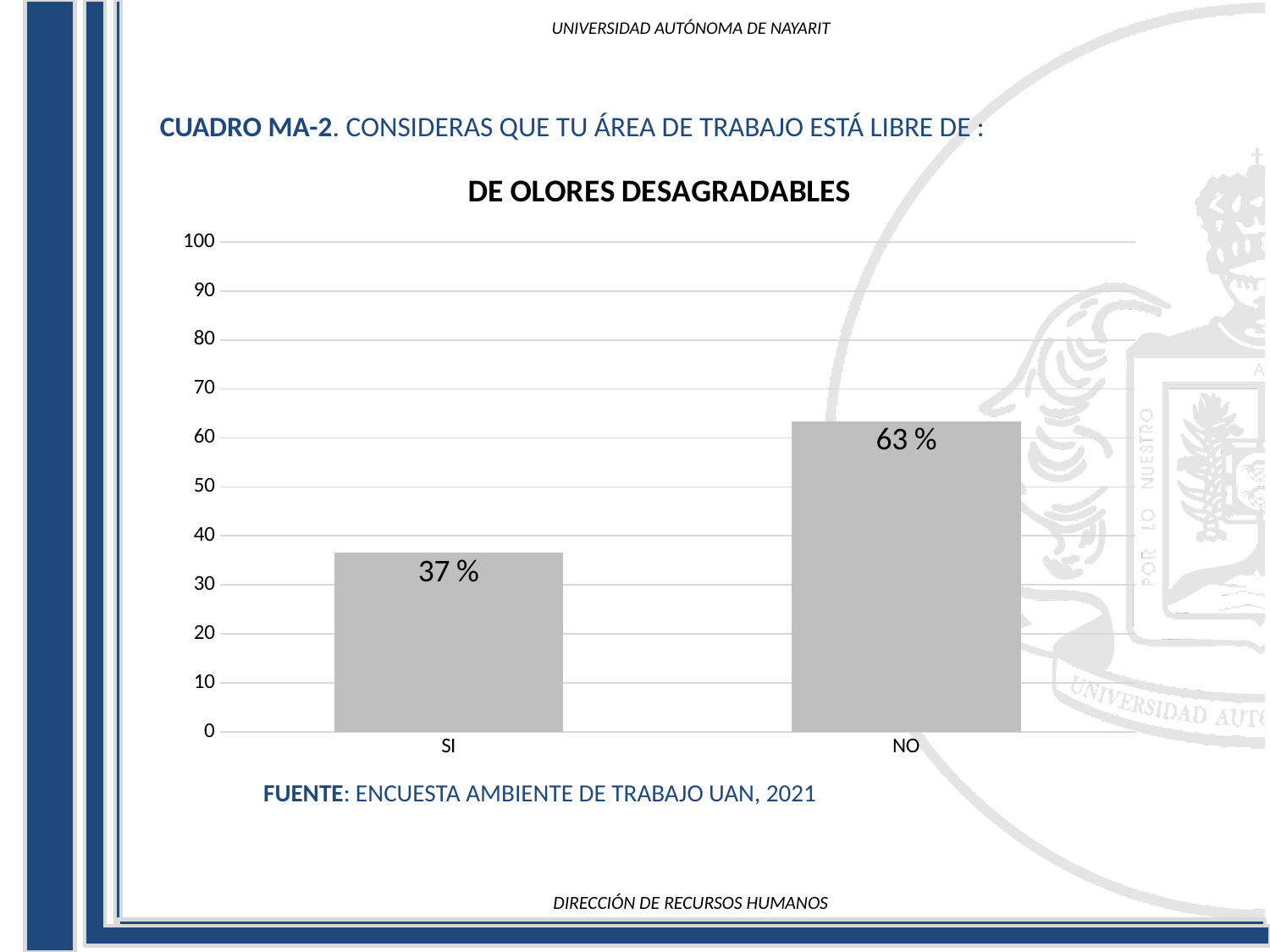
What kind of chart is shown on the slide? bar chart What is the value for NO? 63 % Which is larger, the value for SI or the value for NO? NO What is the value for SI? 37 % Which category has the lowest value? SI Which category has the highest value? NO How many categories are shown on the x axis? 2 Is the value for NO greater or less than 60? greater What is the title of the chart? DE OLORES DESAGRADABLES What is the source cited below the chart? ENCUESTA AMBIENTE DE TRABAJO UAN, 2021 Is the value for SI greater or less than 40? less What is the difference between the values for NO and SI? 26 %